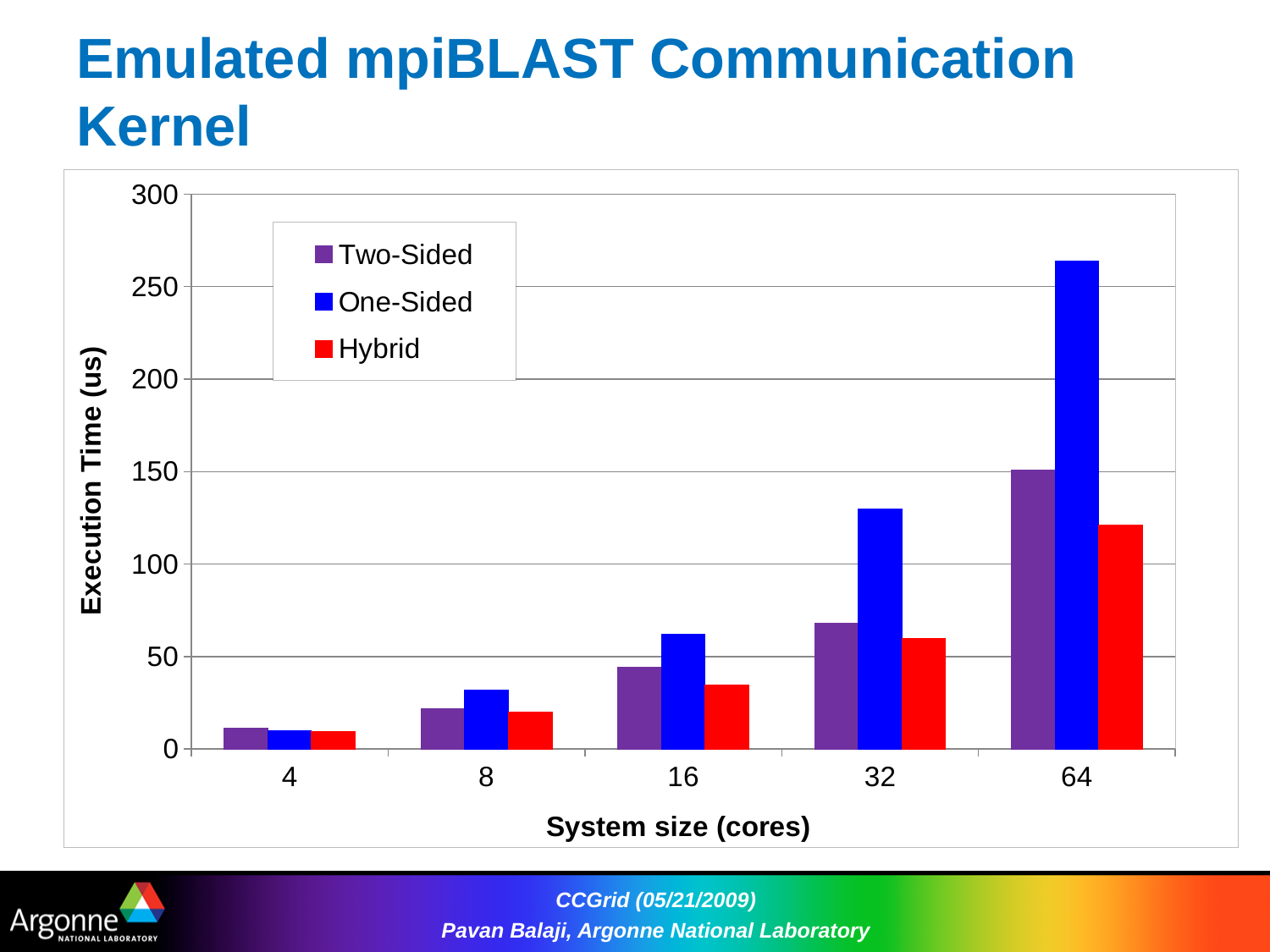
Which series has the highest execution time at a system size of 64 cores? One-Sided What kind of chart is shown on the slide? bar chart How many series does the legend list? 3 Which series has the lowest execution time at a system size of 64 cores? Hybrid Is the Two-Sided execution time at 16 cores greater or less than 50? less Does the One-Sided execution time rise or fall as the system size increases? rise How many system sizes are shown on the x axis? 5 Is the One-Sided execution time at 32 cores greater or less than 100? greater Is the One-Sided execution time at 64 cores greater or less than 250? greater At 32 cores, which has the larger execution time, One-Sided or Two-Sided? One-Sided What is the label of the y axis? Execution Time (us)